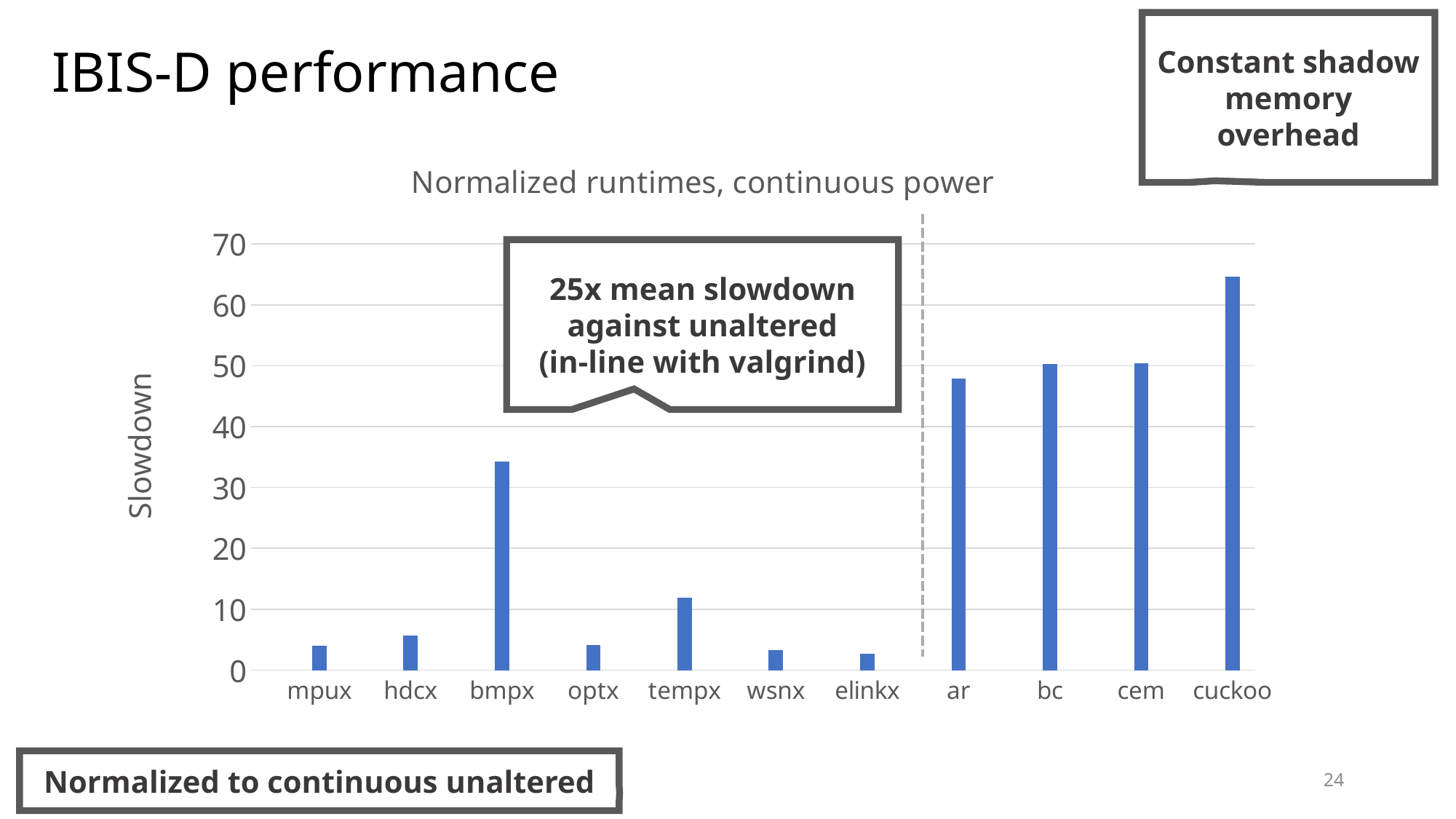
Is the slowdown for cem greater or less than 40? greater What kind of chart is shown on the slide? bar chart Is the slowdown for cuckoo greater or less than 60? greater How many categories are plotted along the x axis of the chart? 11 What is the label on the vertical axis of the chart? Slowdown What is the title of the chart? Normalized runtimes, continuous power Is the slowdown for bmpx greater or less than 30? greater Which category has the highest slowdown in the chart? cuckoo Which has the larger slowdown, cuckoo or bc? cuckoo Which has the larger slowdown, bmpx or tempx? bmpx